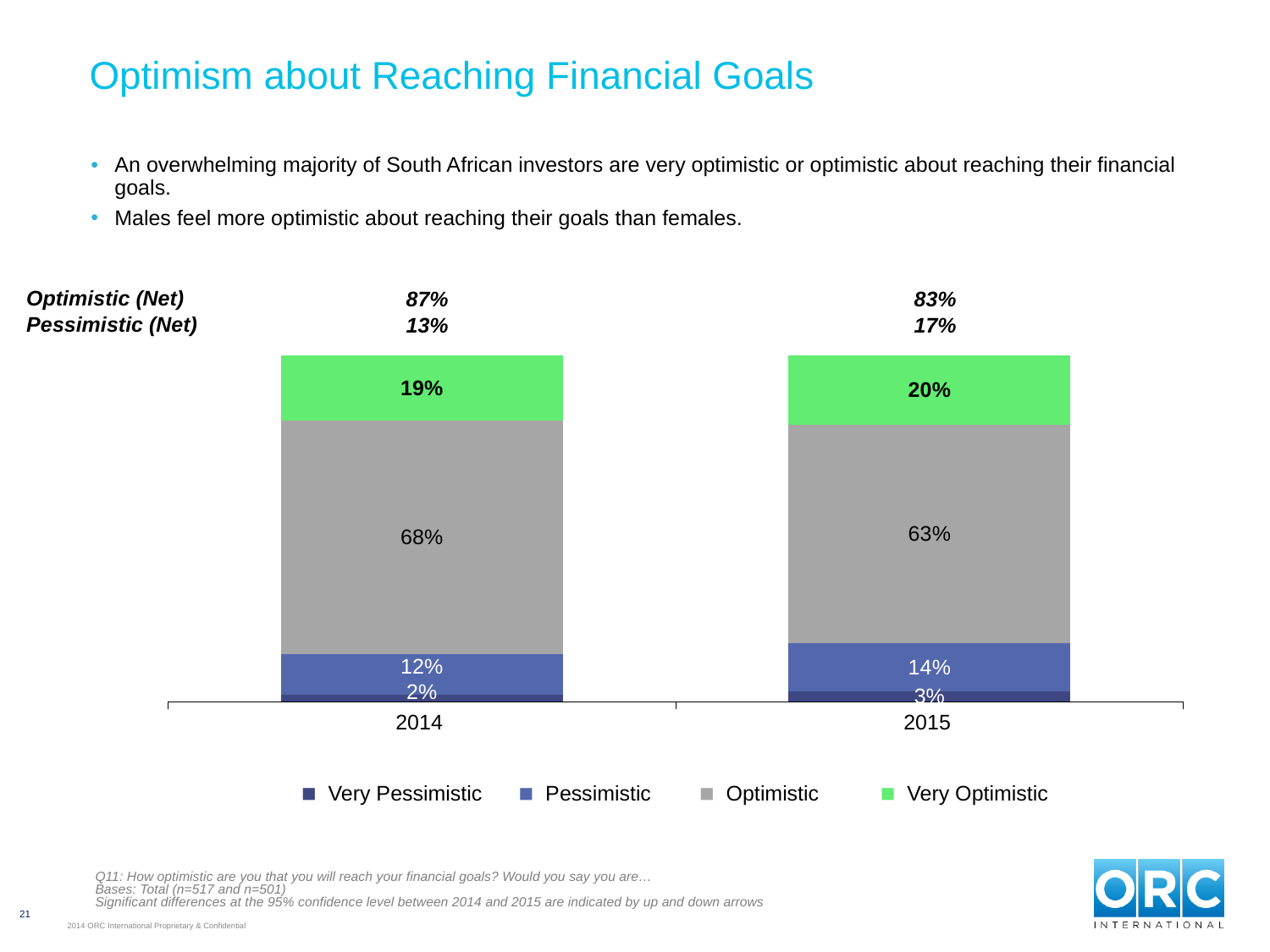
What is the difference between the Optimistic percentage in 2014 and in 2015? 5% What percentage of investors were Pessimistic in 2015? 14% How many years are shown on the x axis? 2 What is the Optimistic (Net) value for 2015? 83% What is the difference between the Pessimistic percentage in 2015 and in 2014? 2% What percentage of investors were Very Optimistic in 2015? 20% What is the Pessimistic (Net) value for 2014? 13% How many series does the legend list? 4 Which year had the higher Optimistic percentage, 2014 or 2015? 2014 What kind of chart is shown on the slide? Stacked bar chart What percentage of investors were Optimistic in 2014? 68% What percentage of investors were Very Pessimistic in 2014? 2%